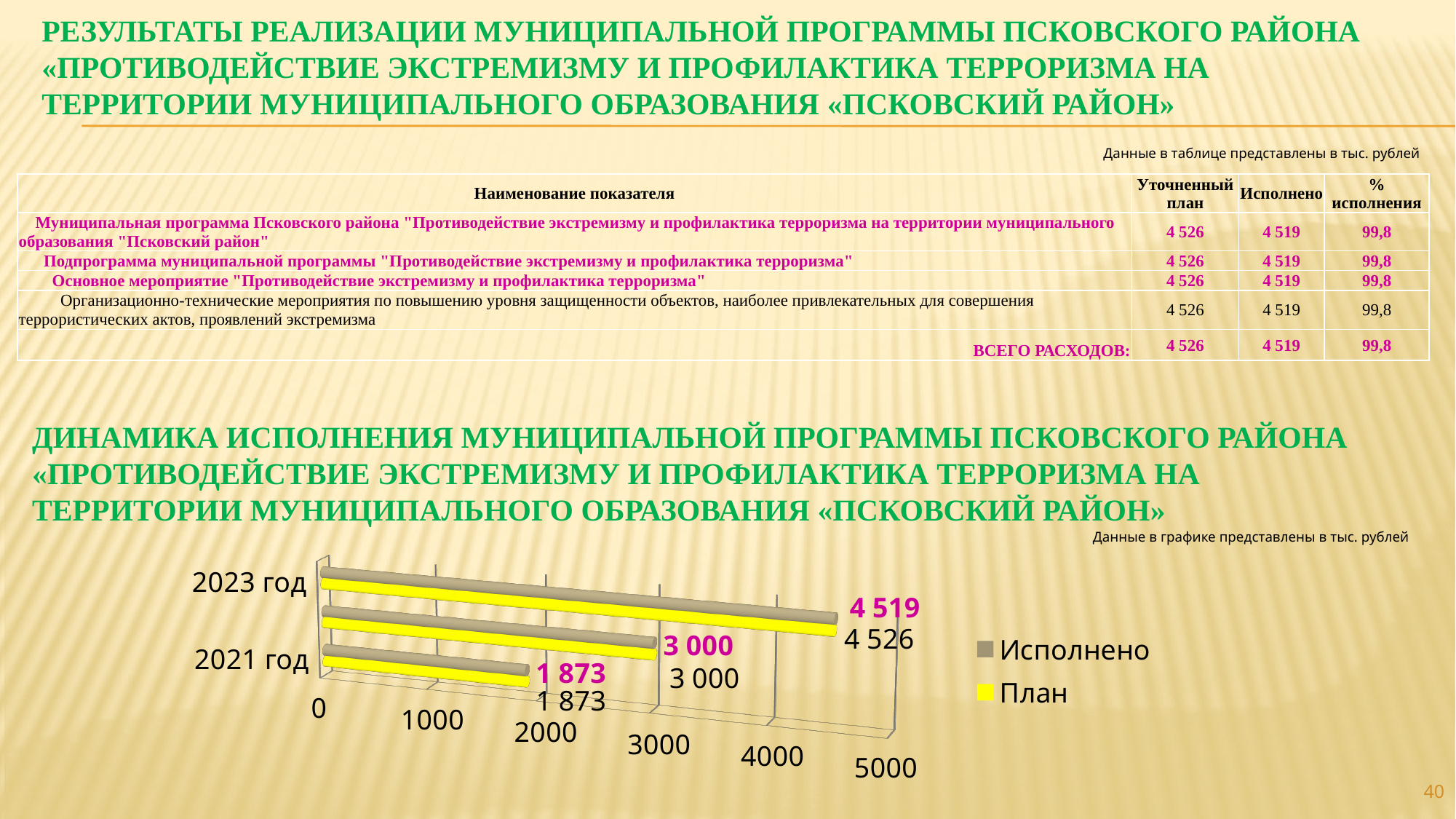
Which year has the highest Исполнено value? 2023 год What kind of chart is shown on the slide? bar chart Which year has the lowest План value? 2021 год What is the value of Исполнено for 2021 год? 1 873 Is the Исполнено value for 2021 год greater or less than 2000? less What is the difference between План and Исполнено for 2023 год? 7 How many series does the legend list? 2 What is the value of План for 2023 год? 4 526 What is the value of План for 2021 год? 1 873 What is the difference between the Исполнено values for 2023 год and 2021 год? 2 646 What is the value of Исполнено for 2023 год? 4 519 Which colour represents the План series in the chart? yellow